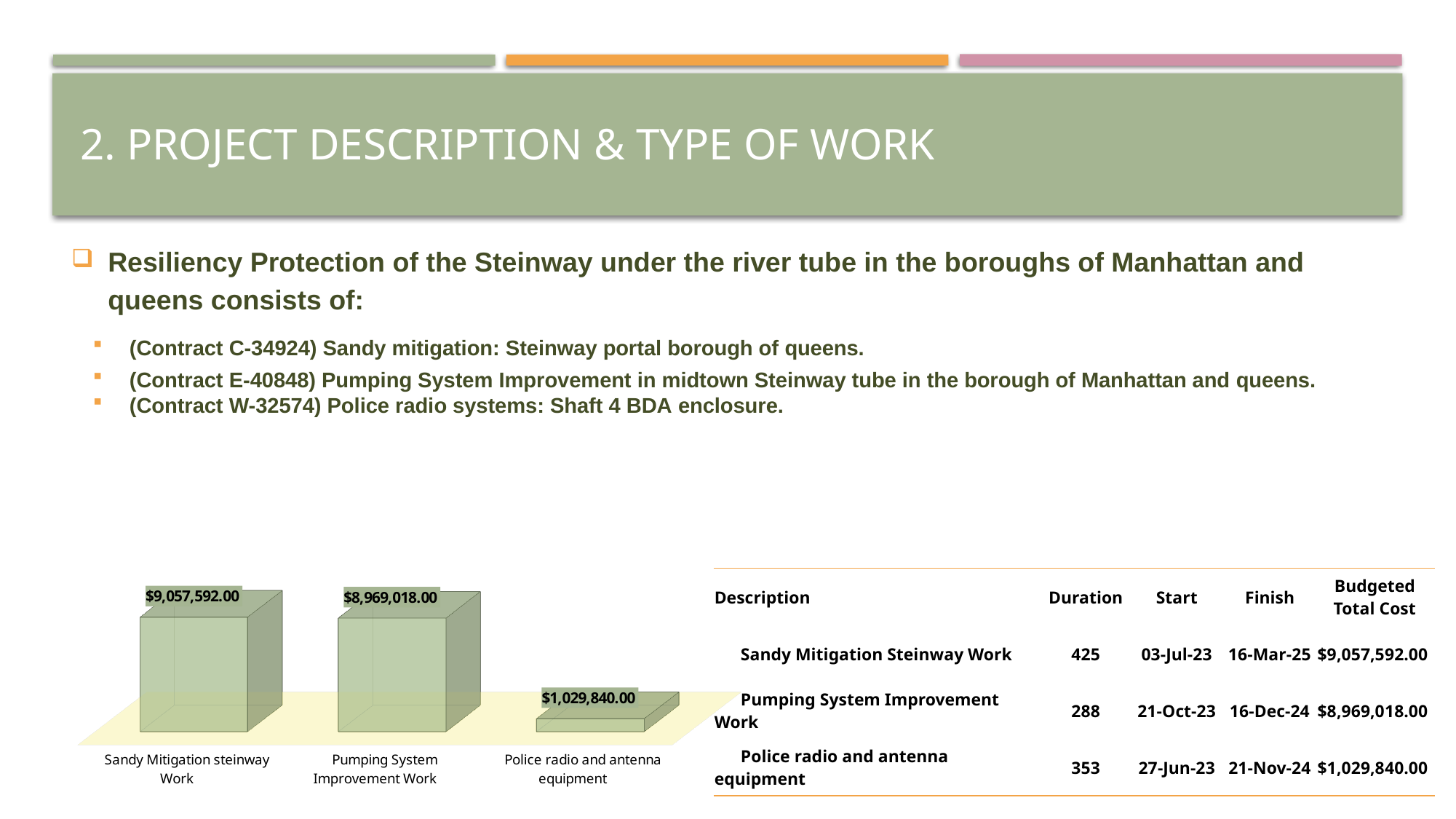
What is the difference between the values for Sandy Mitigation steinway Work and Pumping System Improvement Work in the bar chart? $88,574.00 In the bar chart, which is larger: the value for Police radio and antenna equipment or the value for Pumping System Improvement Work? Pumping System Improvement Work What is the difference between the values for Pumping System Improvement Work and Police radio and antenna equipment in the bar chart? $7,939,178.00 What is the value shown for Sandy Mitigation steinway Work in the bar chart? $9,057,592.00 What is the value shown for Police radio and antenna equipment in the bar chart? $1,029,840.00 How many categories are shown in the bar chart? 3 Which category has the lowest value in the bar chart? Police radio and antenna equipment In the bar chart, which is larger: the value for Sandy Mitigation steinway Work or the value for Pumping System Improvement Work? Sandy Mitigation steinway Work Which category has the highest value in the bar chart? Sandy Mitigation steinway Work What kind of chart is shown on the slide? Bar chart What is the value shown for Pumping System Improvement Work in the bar chart? $8,969,018.00 Do the values in the bar chart rise or fall from left to right? Fall